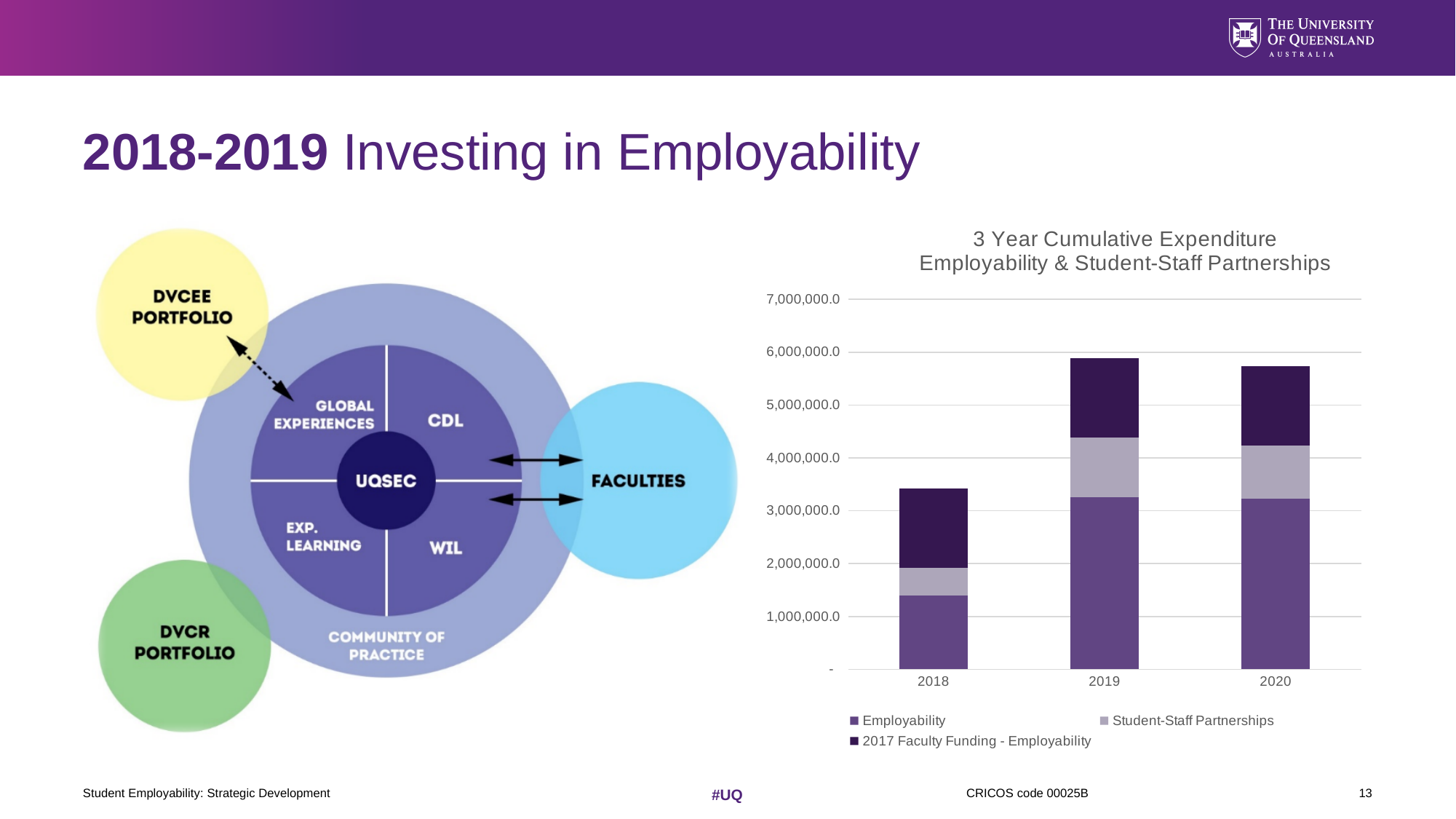
Is the total bar for 2019 greater or less than 5,000,000.0? greater How many series does the chart's legend list? 3 How many years are shown on the x axis of the chart? 3 Is the total bar for 2020 greater or less than 6,000,000.0? less Is the total bar for 2018 greater or less than 3,000,000.0? greater What kind of chart is shown on the slide? Stacked bar chart Which year has the larger total bar, 2018 or 2019? 2019 Does the total expenditure rise or fall from 2018 to 2019? rise Which series is shown in the darkest colour at the top of each bar? 2017 Faculty Funding - Employability Which year has the lowest total cumulative expenditure? 2018 What is the title of the chart? 3 Year Cumulative Expenditure Employability & Student-Staff Partnerships